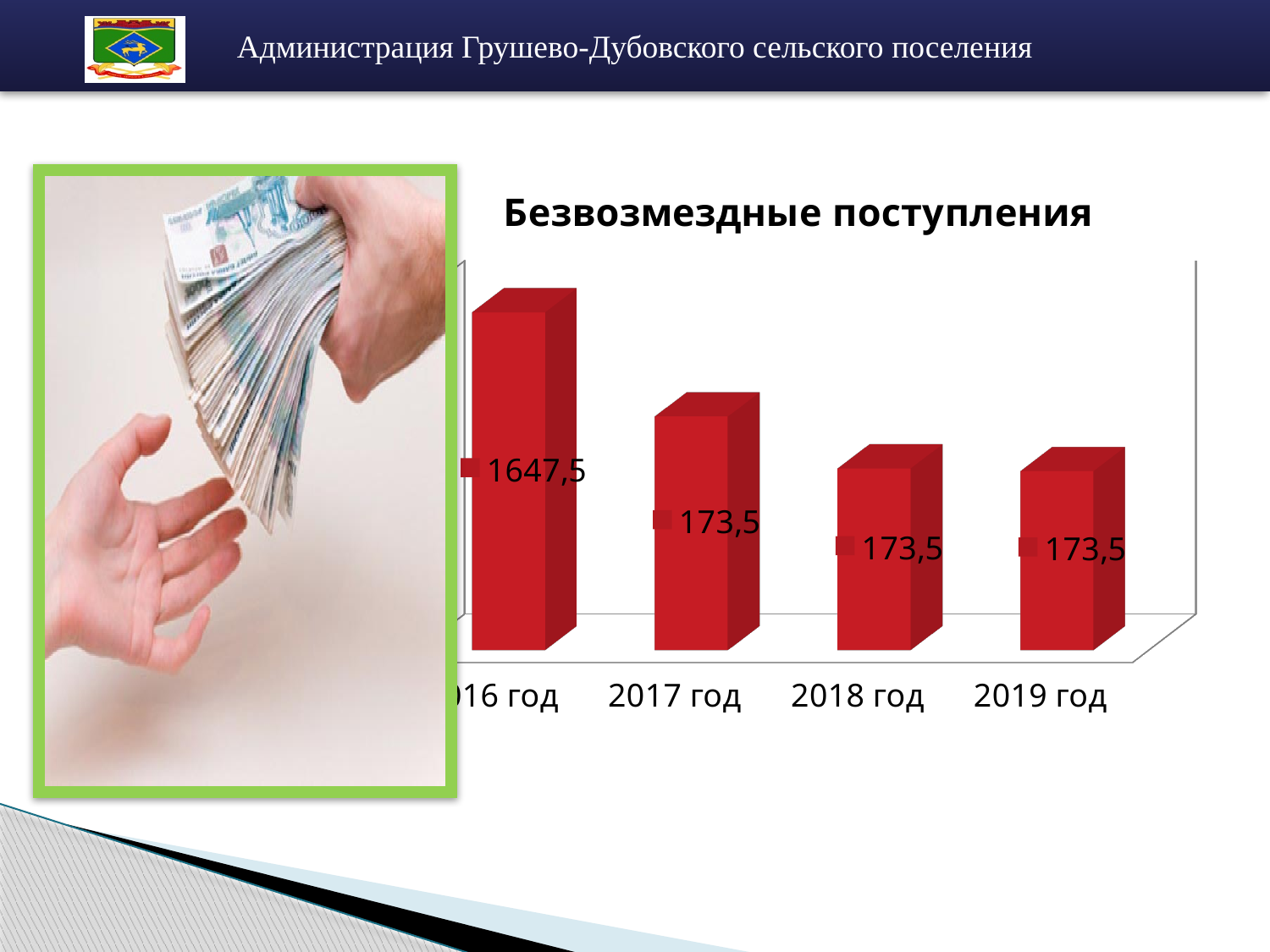
What is the value for 2017 год in the Безвозмездные поступления chart? 173,5 Which is larger in the Безвозмездные поступления chart, the value for 2016 год or the value for 2019 год? 2016 год Which year has the highest value in the Безвозмездные поступления chart? 2016 год What kind of chart is the Безвозмездные поступления chart? bar chart What is the value for 2016 год in the Безвозмездные поступления chart? 1647,5 What is the difference between the values for 2016 год and 2017 год in the Безвозмездные поступления chart? 1474 What is the value for 2019 год in the Безвозмездные поступления chart? 173,5 What is the value for 2018 год in the Безвозмездные поступления chart? 173,5 What colour are the bars in the Безвозмездные поступления chart? red What is the title of the chart on the slide? Безвозмездные поступления How many years are shown in the Безвозмездные поступления chart? 4 Does the value rise or fall from 2016 год to 2017 год in the Безвозмездные поступления chart? fall